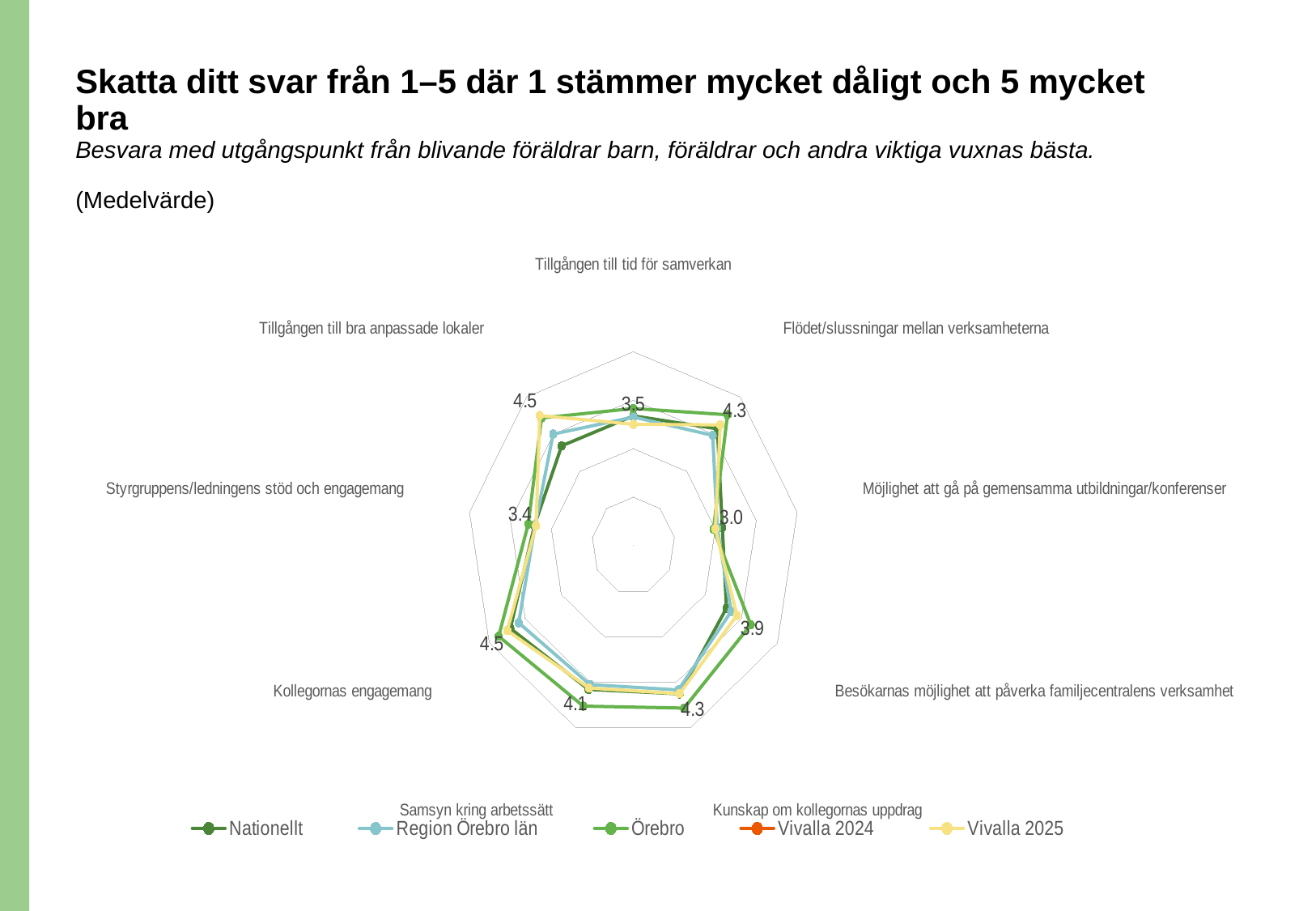
What is the difference between the labelled values for Flödet/slussningar mellan verksamheterna (4.3) and Möjlighet att gå på gemensamma utbildningar/konferenser (3.0)? 1.3 What kind of chart is shown on the slide? Radar chart Which series is listed first in the legend? Nationellt What data label is shown for Flödet/slussningar mellan verksamheterna? 4.3 What data label is shown for Samsyn kring arbetssätt? 4.1 What data label is shown for Styrgruppens/ledningens stöd och engagemang? 3.4 What data label is shown for Tillgången till tid för samverkan? 3.5 How many categories (axes) does the radar chart have? 9 How many series does the legend list? 5 Which has the larger labelled value: Samsyn kring arbetssätt or Kunskap om kollegornas uppdrag? Kunskap om kollegornas uppdrag What data label is shown for Möjlighet att gå på gemensamma utbildningar/konferenser? 3.0 Which labelled category has the lowest value on the chart? Möjlighet att gå på gemensamma utbildningar/konferenser